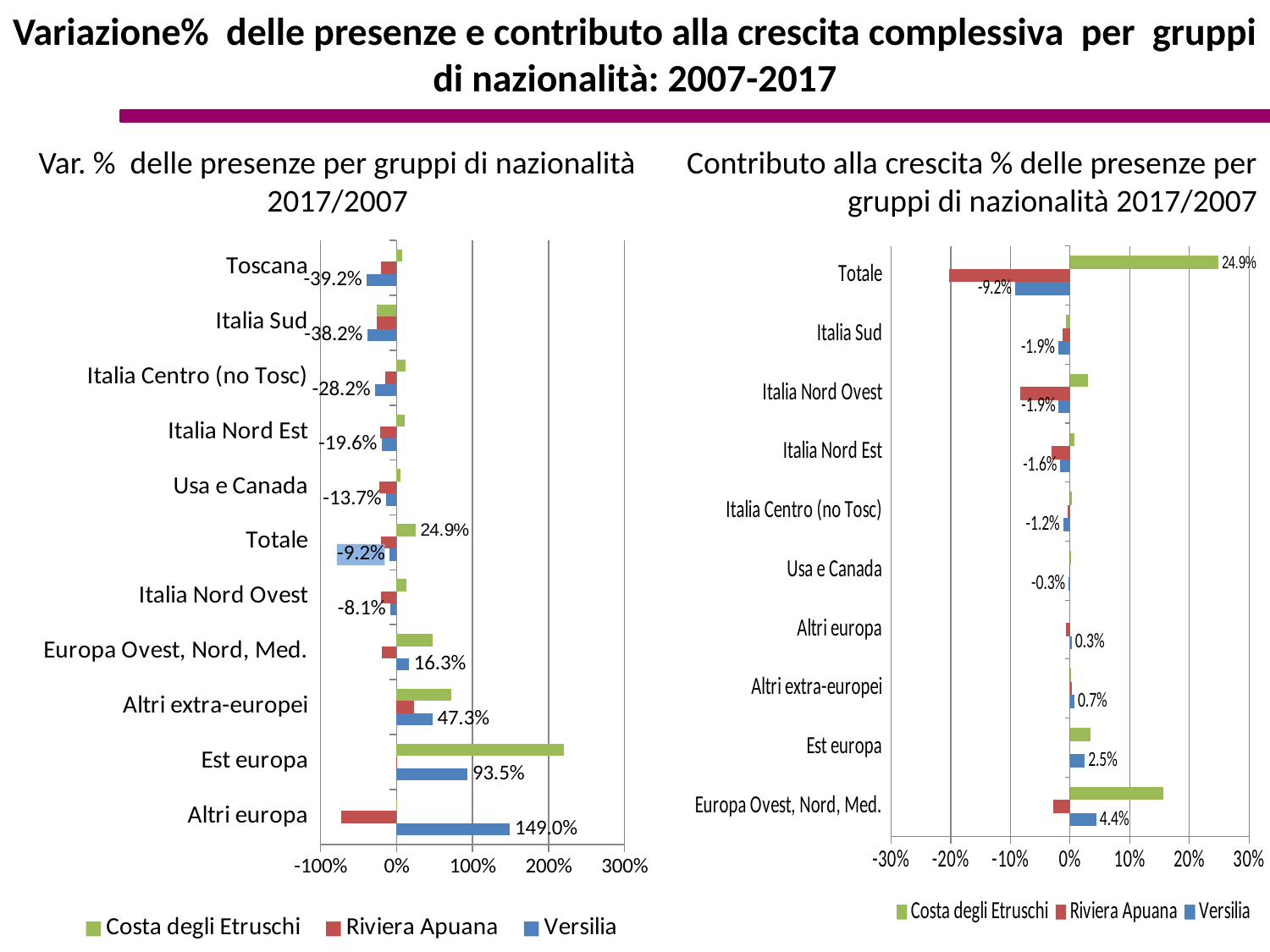
In the left chart (Var. % delle presenze per gruppi di nazionalità 2017/2007), what is the Versilia value for Est europa? 93.5% How many series does the legend of the left chart list? 3 In the left chart (Var. % delle presenze per gruppi di nazionalità 2017/2007), which is larger for Versilia: Altri extra-europei or Europa Ovest, Nord, Med.? Altri extra-europei In the right chart (Contributo alla crescita % delle presenze per gruppi di nazionalità 2017/2007), is the Riviera Apuana value for Totale greater or less than -10%? less In the right chart (Contributo alla crescita % delle presenze per gruppi di nazionalità 2017/2007), what is the Versilia value for Europa Ovest, Nord, Med.? 4.4% In the left chart (Var. % delle presenze per gruppi di nazionalità 2017/2007), what is the Costa degli Etruschi value for Totale? 24.9% How many categories are shown in the right chart (Contributo alla crescita % delle presenze per gruppi di nazionalità 2017/2007)? 10 How many categories are shown in the left chart (Var. % delle presenze per gruppi di nazionalità 2017/2007)? 11 What kind of chart is the right chart (Contributo alla crescita % delle presenze per gruppi di nazionalità 2017/2007)? Bar chart In the left chart (Var. % delle presenze per gruppi di nazionalità 2017/2007), what is the Versilia value for Altri europa? 149.0% In the left chart (Var. % delle presenze per gruppi di nazionalità 2017/2007), which category has the highest Versilia value? Altri europa In the left chart (Var. % delle presenze per gruppi di nazionalità 2017/2007), what is the difference between the Versilia values for Altri europa and Est europa? 55.5 percentage points